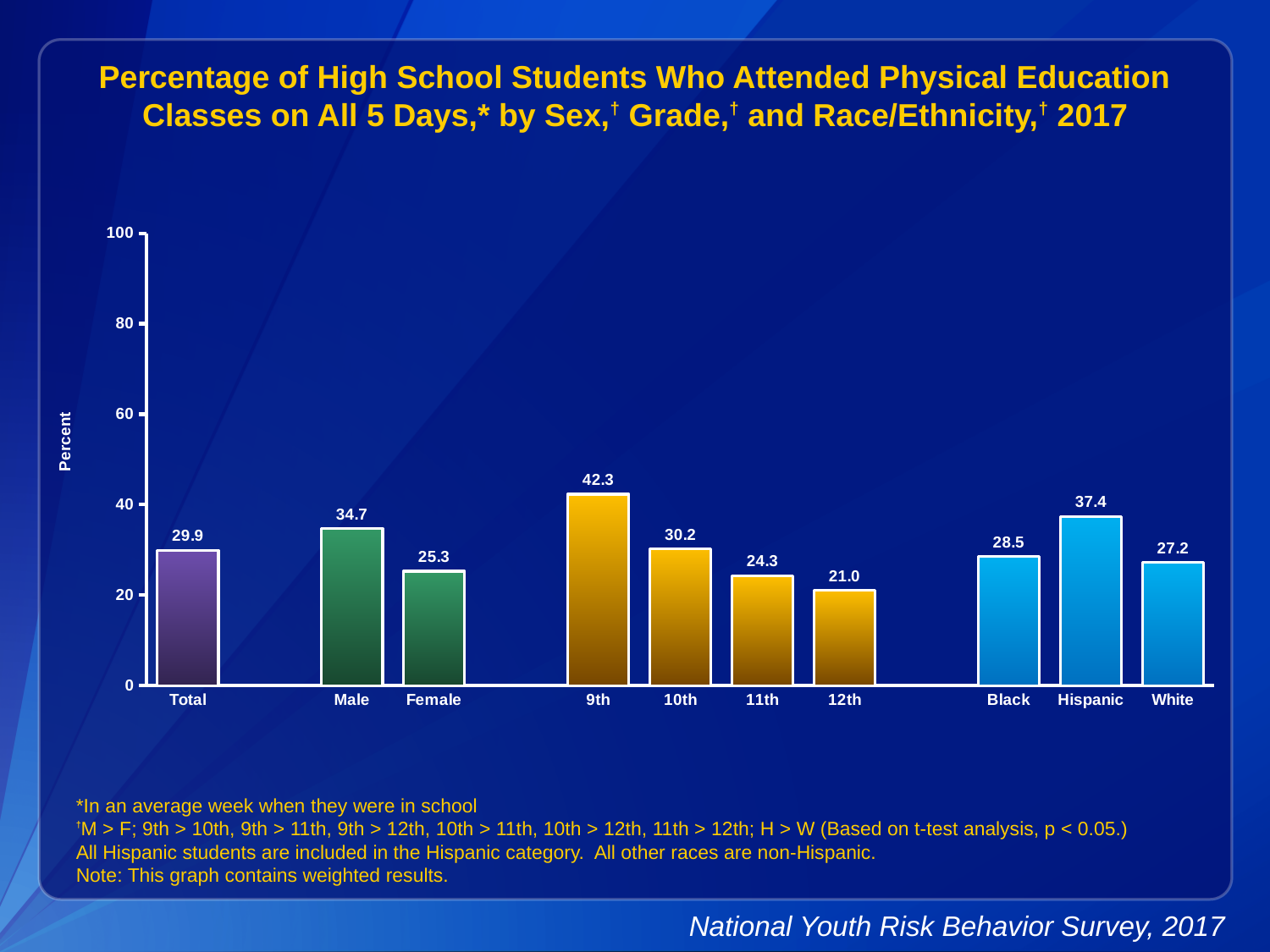
What is the difference between the Male and Female values? 9.4 What is the value for Total? 29.9 Which category has the highest value? 9th What kind of chart is shown? bar chart How many categories are shown on the x axis? 10 What is the value for Hispanic? 37.4 Is the value for 10th grade greater or less than 20? greater Which is larger, the value for Black or the value for White? Black Do the values rise or fall from 9th grade to 12th grade? fall Which category has the lowest value? 12th What is the value for Female? 25.3 What is the value for 12th grade? 21.0